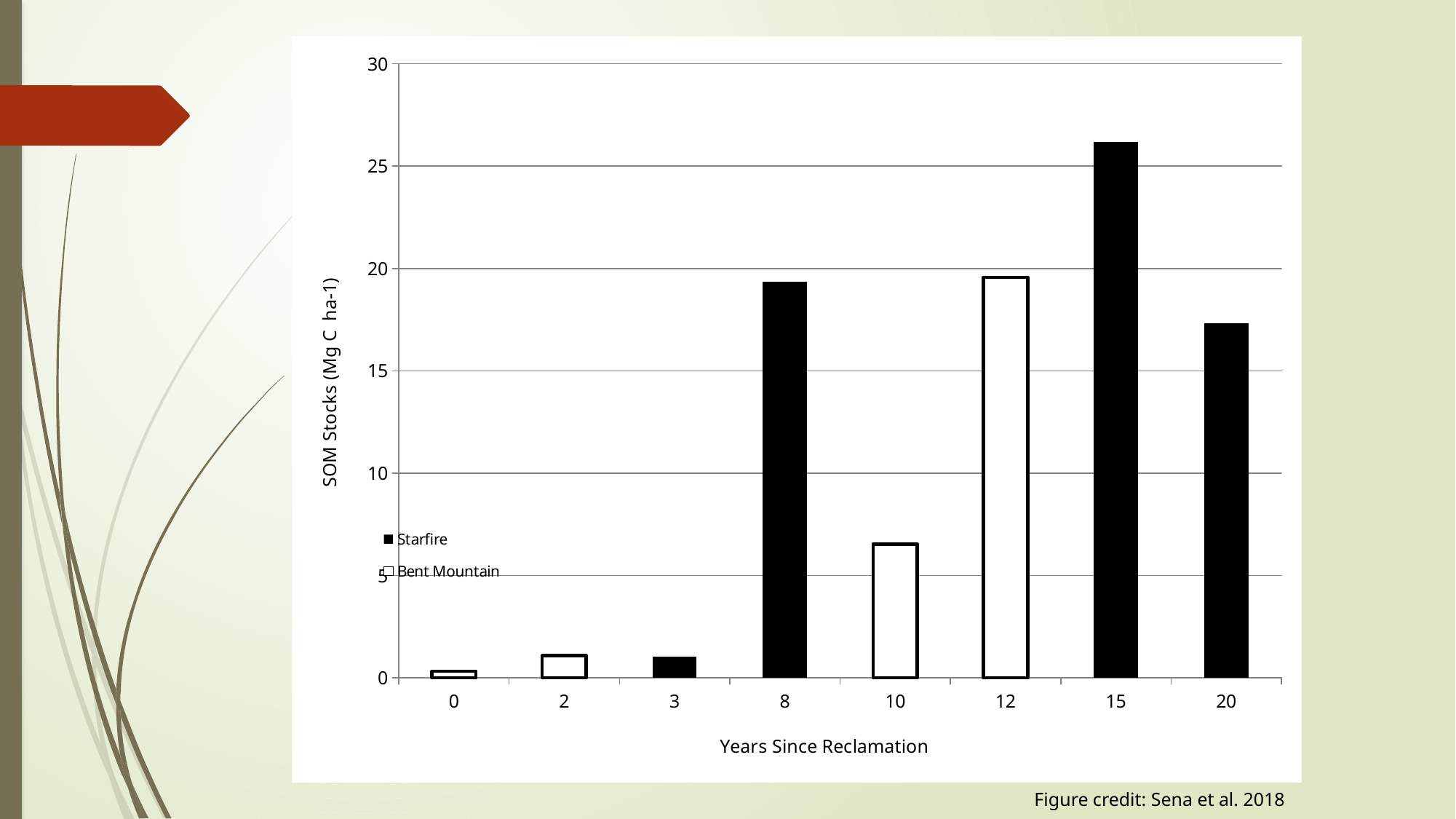
How many series does the legend list? 2 How many categories are shown on the x axis? 8 Which year since reclamation has the highest SOM stock? 15 Is the SOM stock at 15 years since reclamation greater or less than 25? greater Which year since reclamation has the lowest SOM stock? 0 Is the SOM stock at 10 years since reclamation greater or less than 5? greater Which has the larger SOM stock, 15 years or 20 years since reclamation? 15 years Which series is shown with black bars? Starfire Is the SOM stock at 20 years since reclamation greater or less than 20? less What is the label of the y axis? SOM Stocks (Mg C ha-1) What kind of chart is shown on the slide? bar chart